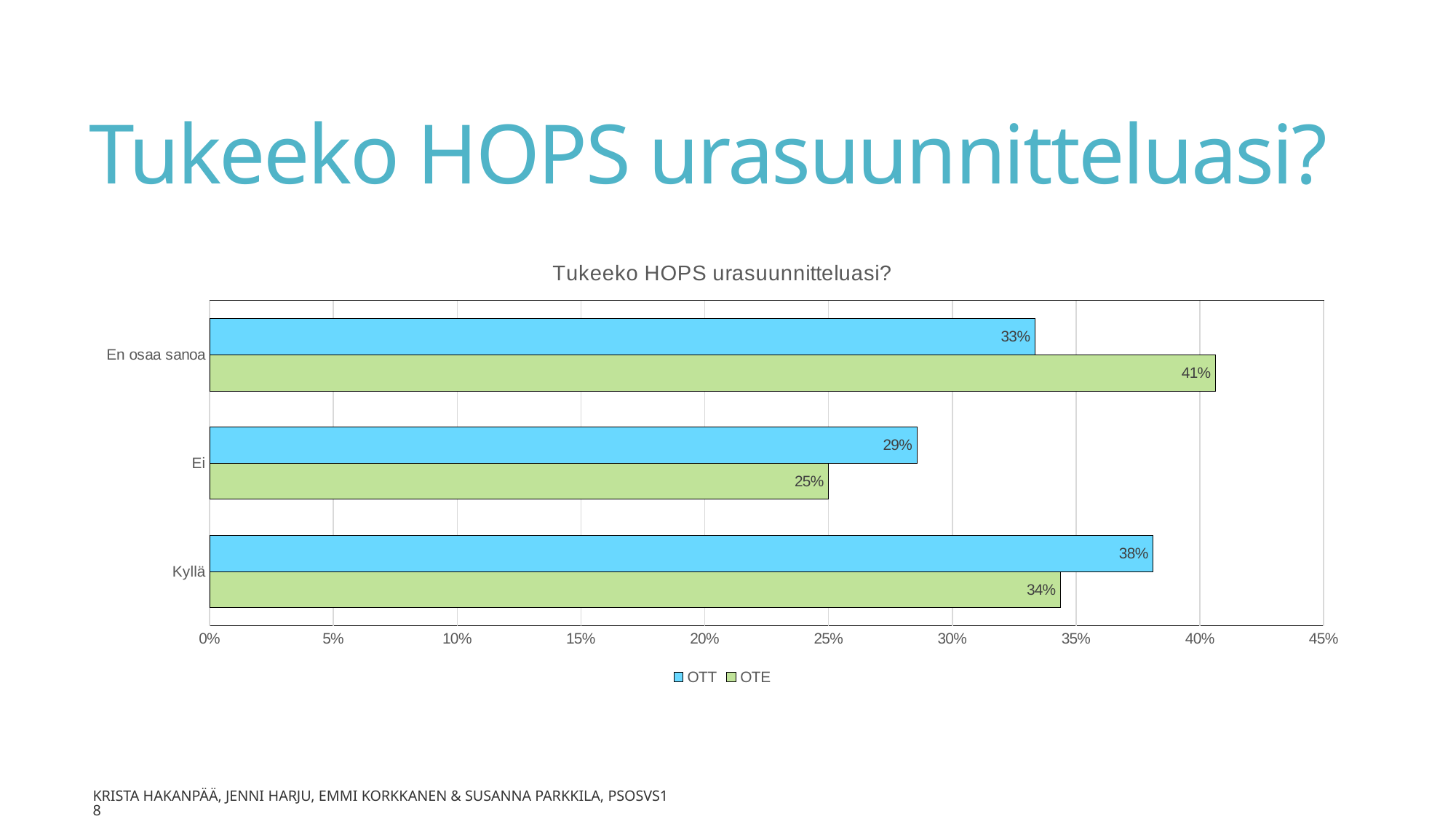
What is the OTE value for "En osaa sanoa"? 41% Which category has the highest OTE value? En osaa sanoa Is the OTT value for "Ei" greater or less than 30%? less What type of chart is shown on the slide? Bar chart What is the OTT value for "En osaa sanoa"? 33% For "Kyllä", which series has the larger value, OTT or OTE? OTT What is the OTT value for "Kyllä"? 38% How many categories are shown on the chart? 3 How many series does the legend list? 2 What is the difference between the OTE and OTT values for "En osaa sanoa"? 8% Which category has the lowest OTT value? Ei What is the OTE value for "Ei"? 25%